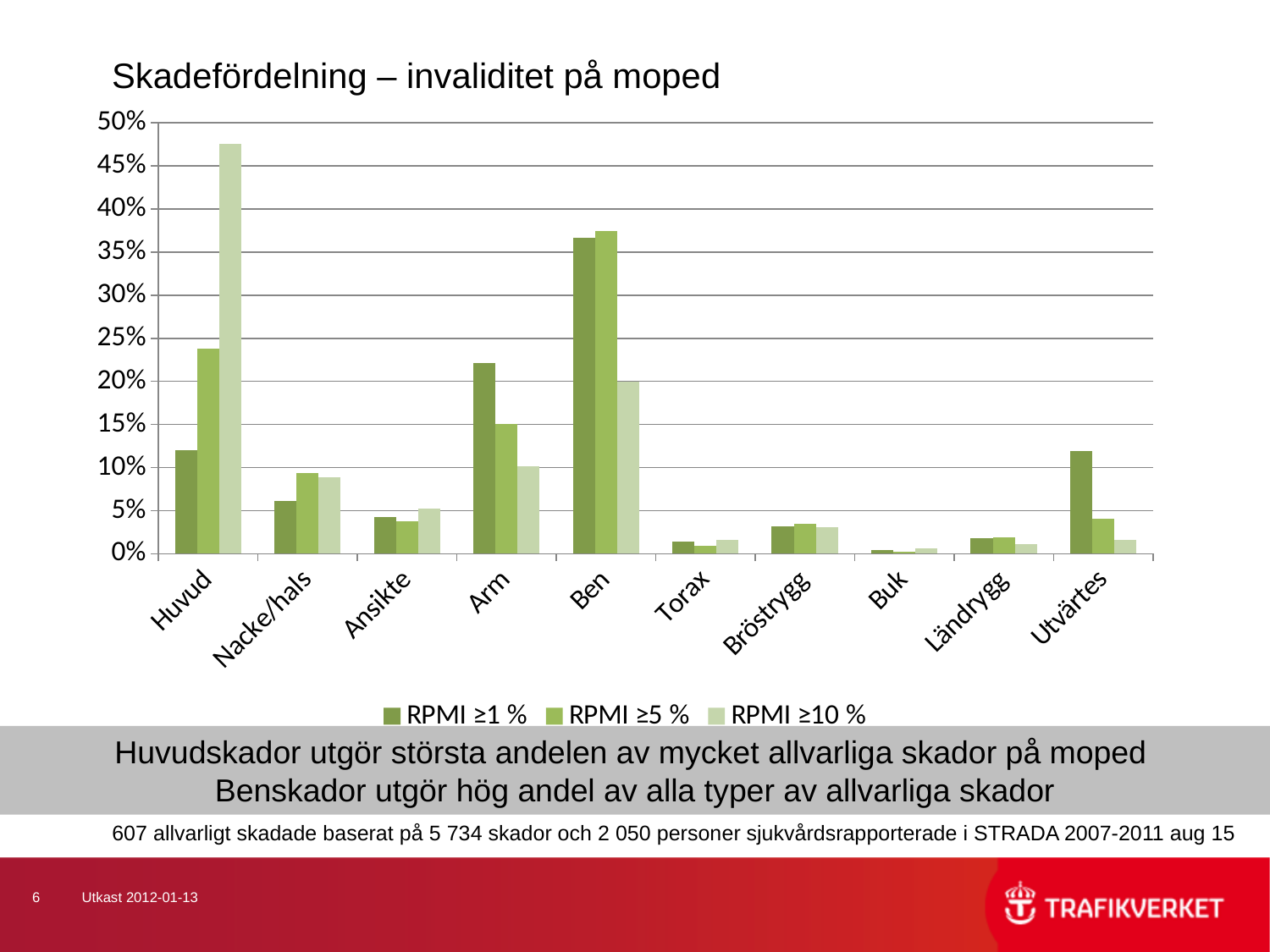
For Huvud, which series has the larger value: RPMI ≥1 % or RPMI ≥10 %? RPMI ≥10 % Is the RPMI ≥1 % value for Arm greater or less than 20%? greater Is the RPMI ≥10 % value for Huvud greater or less than 45%? greater How many series does the legend list? 3 How many injury categories are shown on the x axis? 10 Which category has the lowest value for the RPMI ≥1 % series? Buk Which category has the highest value for the RPMI ≥10 % series? Huvud For the RPMI ≥5 % series, which category has the larger value: Arm or Ben? Ben Which category has the highest value for the RPMI ≥1 % series? Ben Is the RPMI ≥10 % value for Ben greater or less than 25%? less What is the title of the slide containing the chart? Skadefördelning – invaliditet på moped What kind of chart is shown on the slide? bar chart